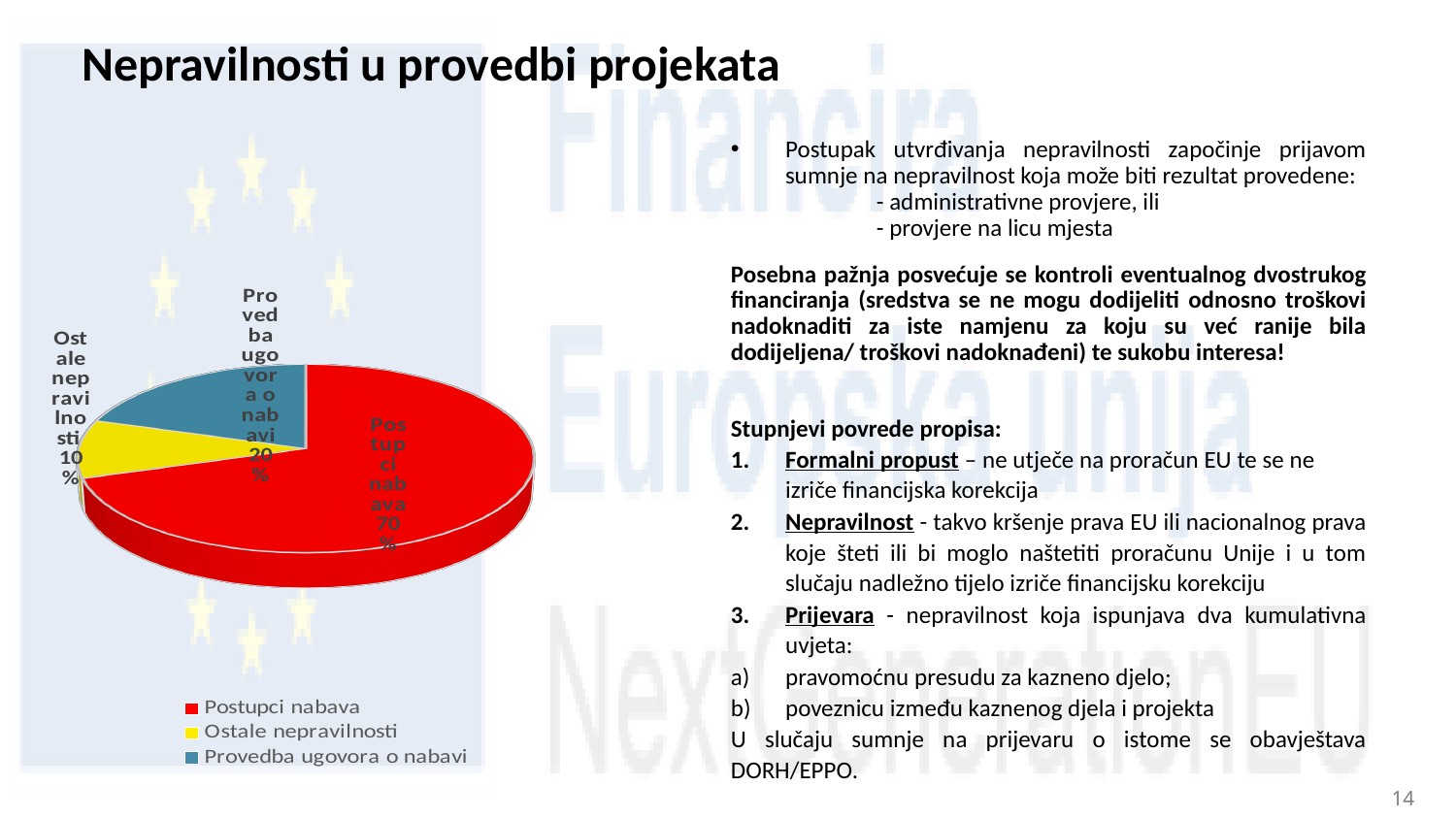
What colour is the slice for Postupci nabava? red What share of the pie does Postupci nabava have? 70% Which is larger, the slice for Provedba ugovora o nabavi or the slice for Ostale nepravilnosti? Provedba ugovora o nabavi What share of the pie does Provedba ugovora o nabavi have? 20% What colour is the slice for Ostale nepravilnosti? yellow How many categories does the pie chart show? 3 How many entries does the legend list? 3 What share of the pie does Ostale nepravilnosti have? 10% Which category has the largest slice of the pie? Postupci nabava Which category has the smallest slice of the pie? Ostale nepravilnosti What is the difference in percentage points between Postupci nabava and Provedba ugovora o nabavi? 50 What kind of chart is shown on the slide? pie chart